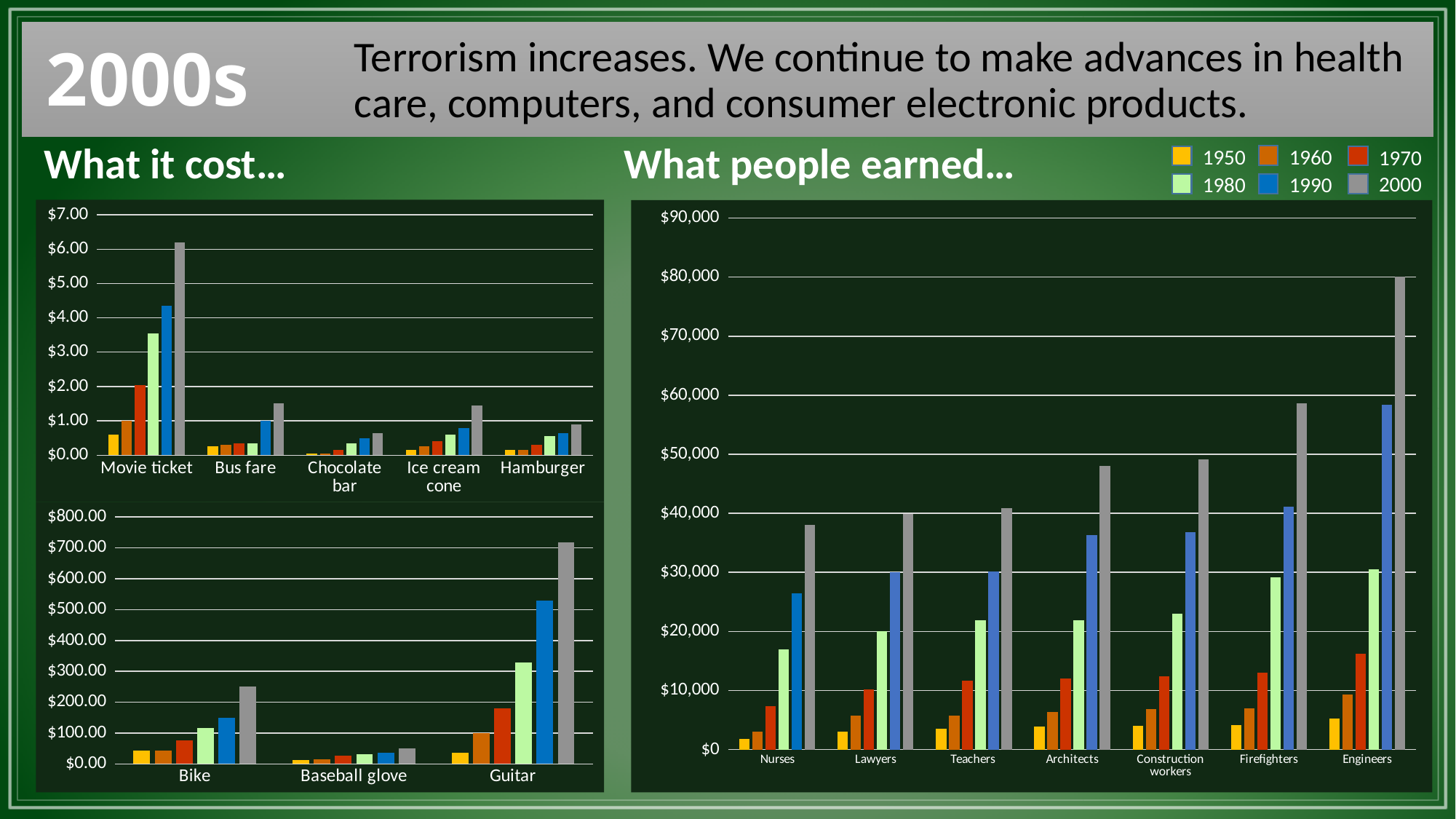
In the 'What people earned...' chart, which occupation has the highest bar for 2000? Engineers In the bottom-left chart, which is larger: the 2000 value for Guitar or the 2000 value for Bike? Guitar In the 'What people earned...' chart, do the 2000 values rise or fall moving from Nurses to Engineers along the x axis? rise How many occupations are shown on the x axis of the 'What people earned...' chart? 7 In the top-left 'What it cost...' chart, is the 2000 value for Movie ticket greater or less than $5.00? greater In the 'What people earned...' chart, is the 2000 value for Engineers greater or less than $70,000? greater In the 'What people earned...' chart, which is larger: the 1990 value for Engineers or the 1990 value for Firefighters? Engineers In the bottom-left chart, is the 2000 value for Bike greater or less than $200.00? greater What kind of chart is the 'What people earned...' chart? bar chart In the top-left 'What it cost...' chart, which item has the highest bar for 2000? Movie ticket How many series does the legend list for the charts on this slide? 6